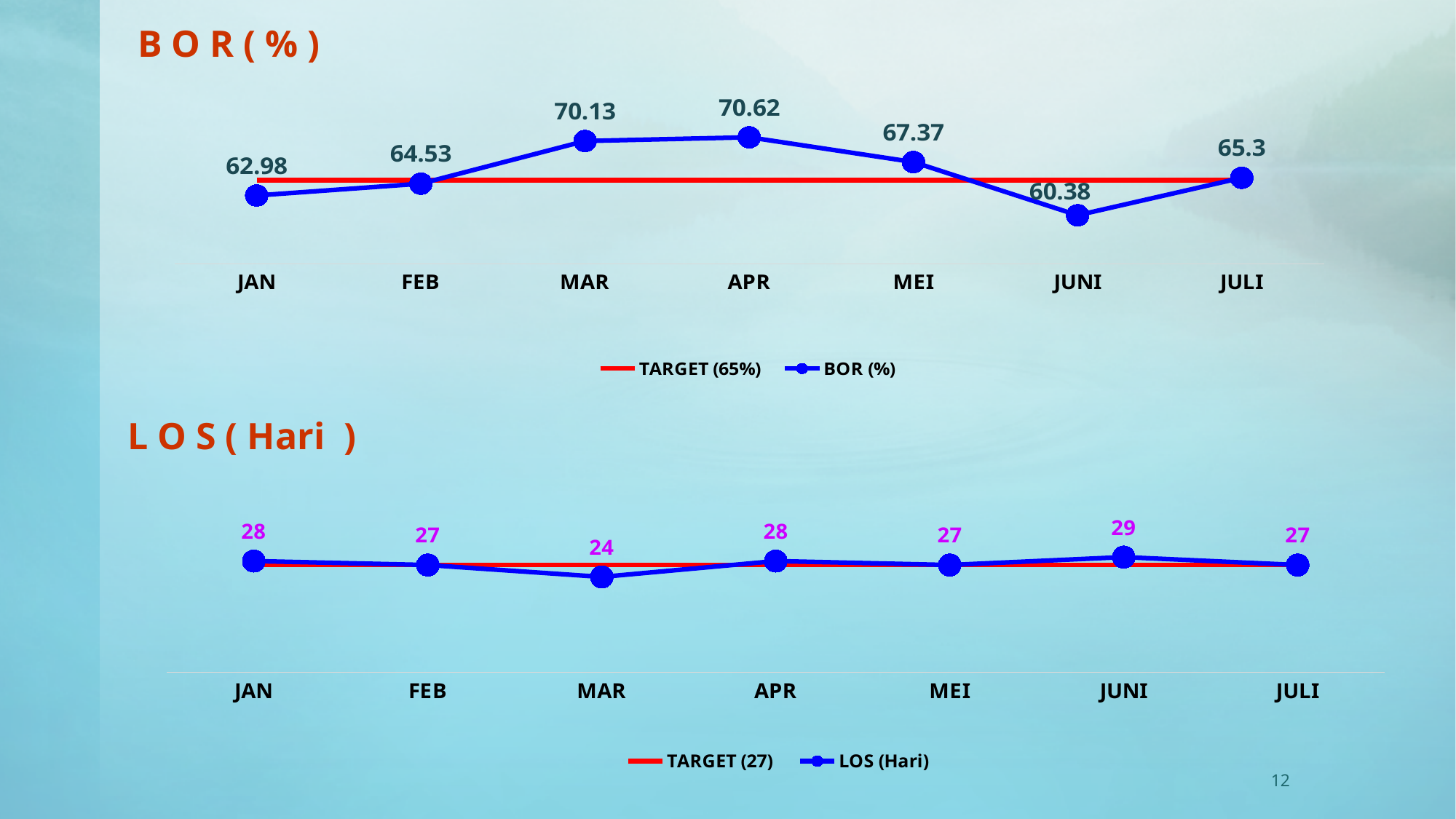
What kind of chart is the LOS (Hari) chart? line chart In the LOS (Hari) chart, what is the difference between the LOS values for JUNI and MAR? 5 In the BOR (%) chart, what target value is named in the legend? 65% In the BOR (%) chart, what is the BOR value for APR? 70.62 In the BOR (%) chart, how many series does the legend list? 2 In the BOR (%) chart, which month has the lowest BOR value? JUNI In the BOR (%) chart, what is the difference between the BOR values for MAR and JAN? 7.15 In the LOS (Hari) chart, how many months are shown on the x axis? 7 In the LOS (Hari) chart, what is the LOS value for MAR? 24 In the BOR (%) chart, is the BOR value for MEI larger or smaller than the value for JULI? larger In the LOS (Hari) chart, which month has the highest LOS value? JUNI In the BOR (%) chart, which month has the highest BOR value? APR